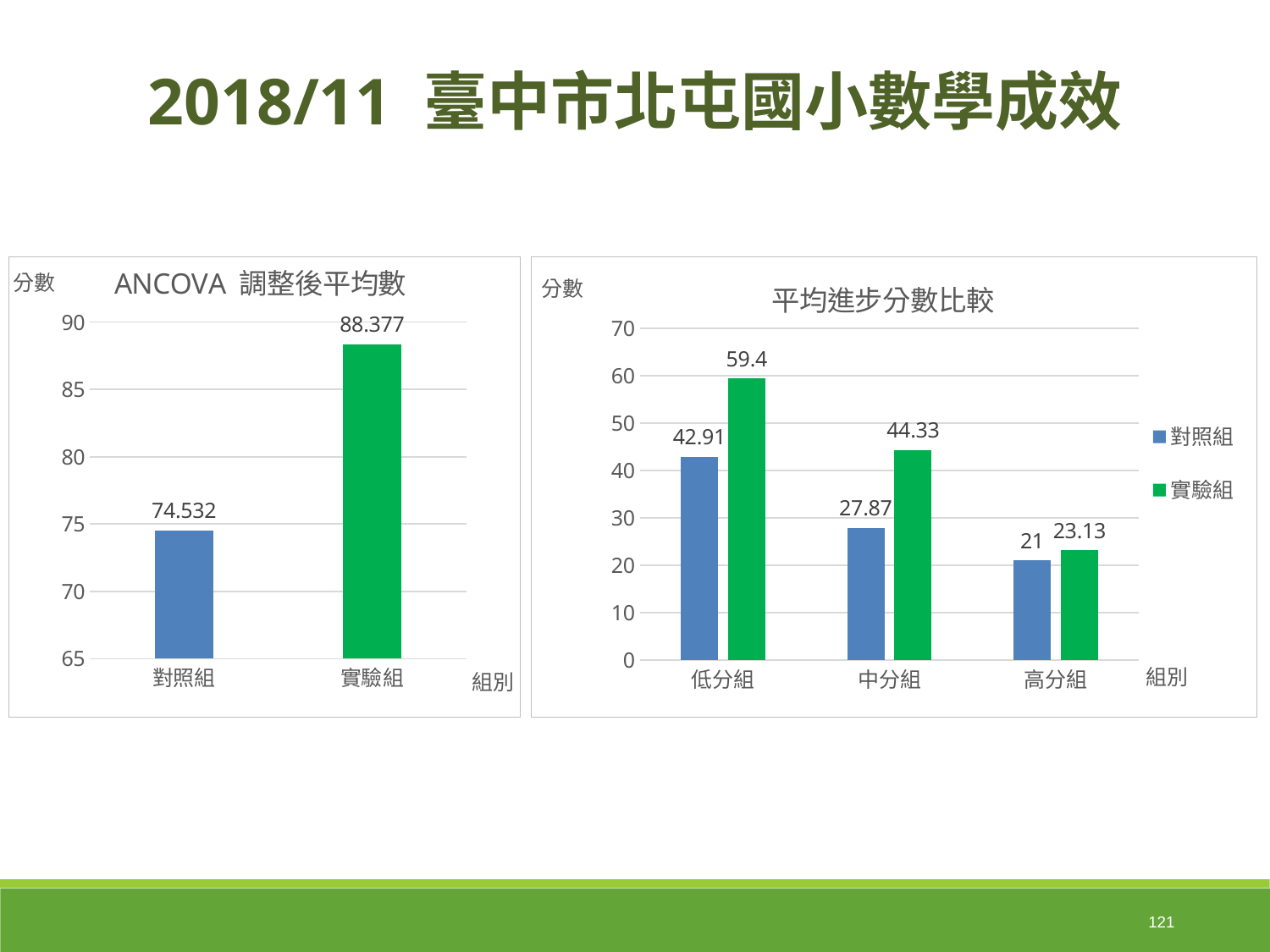
In the ANCOVA 調整後平均數 chart, how many categories are shown on the x axis? 2 In the 平均進步分數比較 chart, which category has the lowest 對照組 value? 高分組 In the 平均進步分數比較 chart, what is the value for 實驗組 in 低分組? 59.4 In the 平均進步分數比較 chart, which is larger in 中分組: 對照組 or 實驗組? 實驗組 What kind of chart is the 平均進步分數比較 chart? Bar chart In the ANCOVA 調整後平均數 chart, what is the value for 對照組? 74.532 In the 平均進步分數比較 chart, how many series does the legend list? 2 In the 平均進步分數比較 chart, what is the difference between 實驗組 and 對照組 in 高分組? 2.13 In the ANCOVA 調整後平均數 chart, what is the value for 實驗組? 88.377 In the 平均進步分數比較 chart, what is the value for 對照組 in 中分組? 27.87 In the 平均進步分數比較 chart, which category has the highest 實驗組 value? 低分組 In the ANCOVA 調整後平均數 chart, what is the difference between 實驗組 and 對照組? 13.845